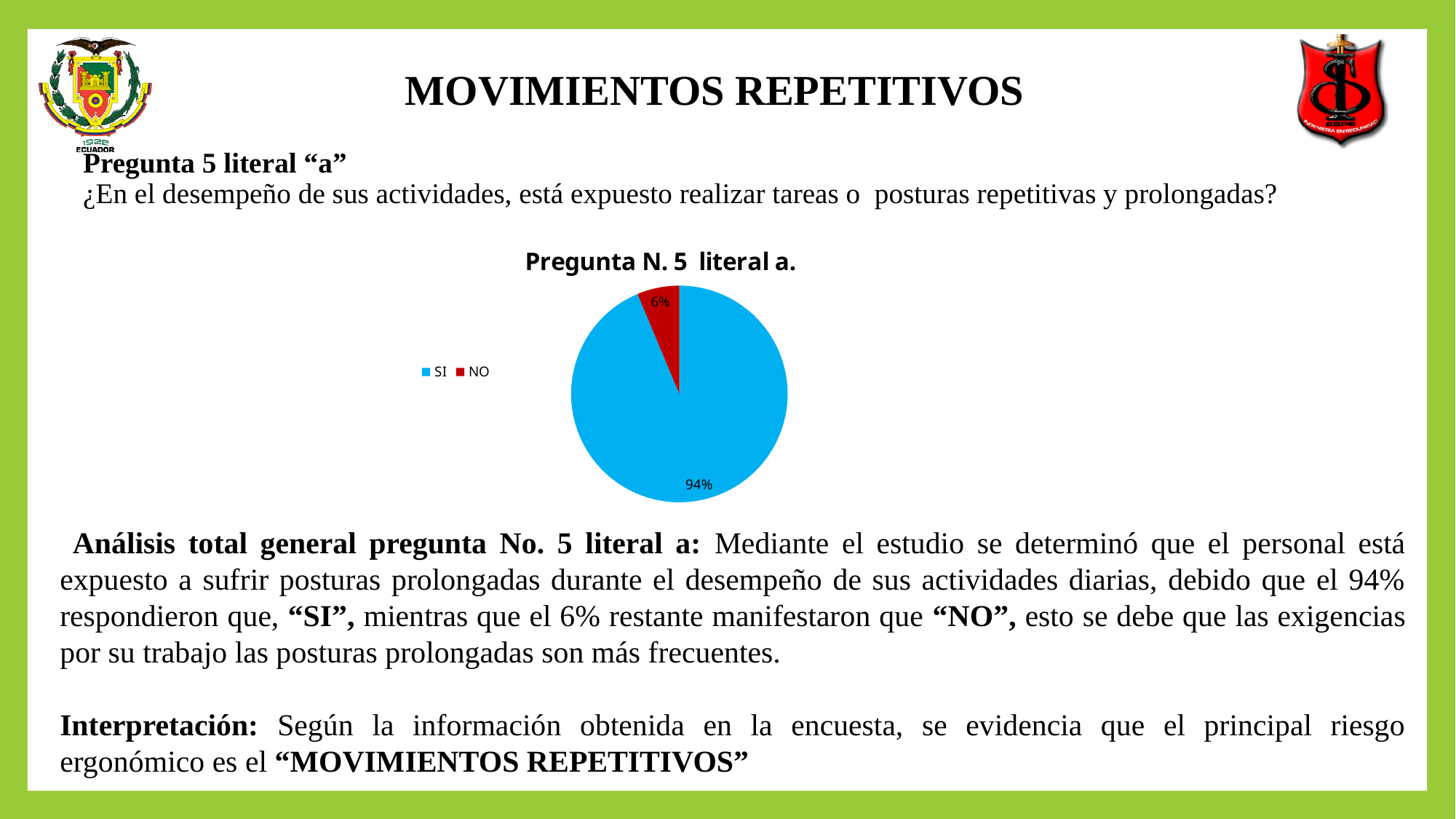
What is the difference in percentage points between the SI and NO slices? 88 Which slice is larger, SI or NO? SI What percentage of the pie corresponds to NO? 6% What colour is the SI slice? blue How many slices does the pie chart have? 2 What share of the pie does the NO slice represent? 6% What percentage of the pie corresponds to SI? 94% Which category has the largest share of the pie? SI What is the title of the chart? Pregunta N. 5 literal a. How many entries does the legend list? 2 Which category has the smallest share of the pie? NO What kind of chart is shown on the slide? pie chart